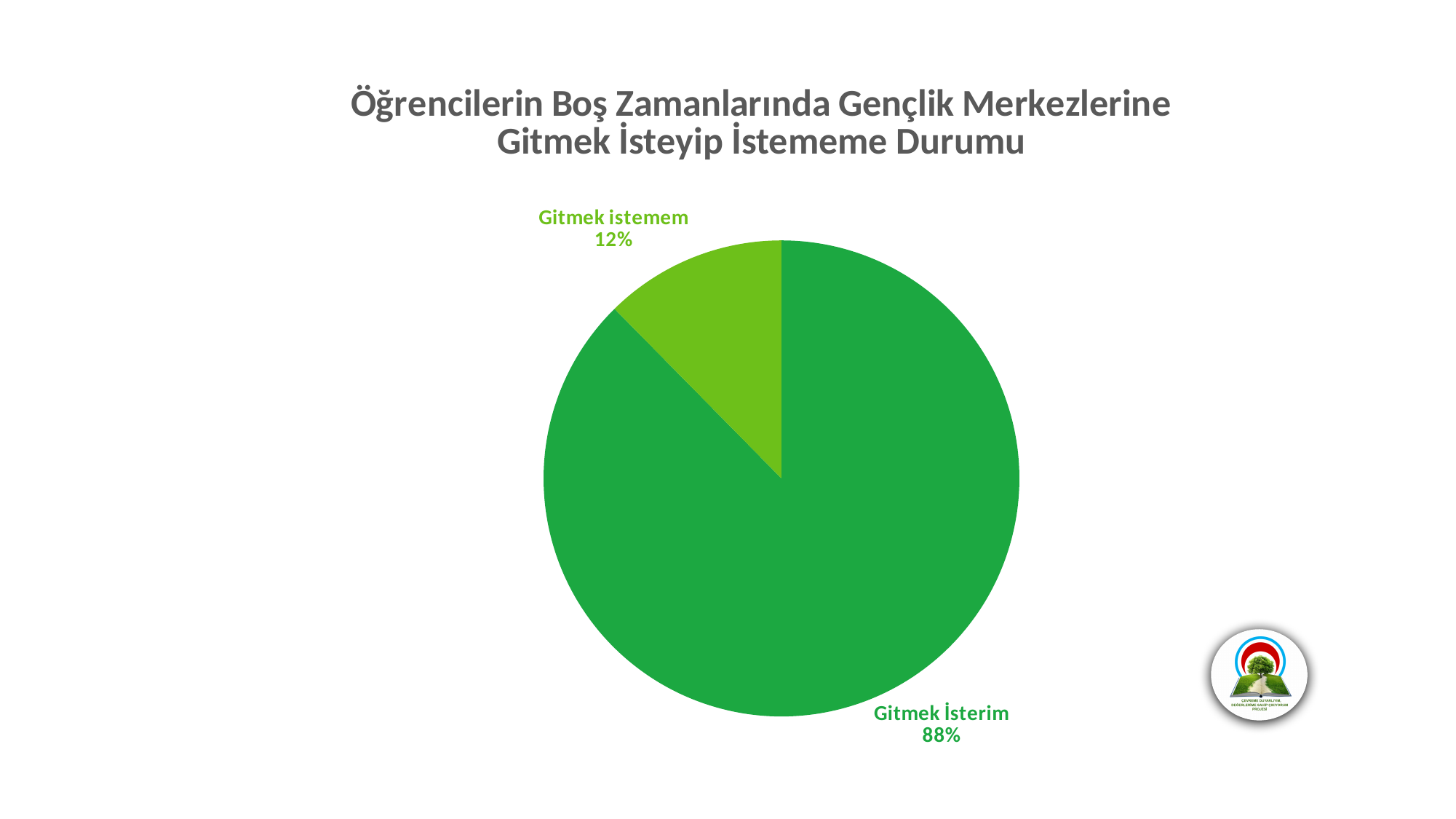
What is the difference in percentage points between "Gitmek İsterim" and "Gitmek istemem"? 76 What share of the pie does the "Gitmek istemem" slice represent? 12% What percentage of students answered "Gitmek istemem"? 12% Which category has the largest share of the pie? Gitmek İsterim What percentage of students answered "Gitmek İsterim"? 88% What kind of chart is shown on the slide? Pie chart What is the title of the chart? Öğrencilerin Boş Zamanlarında Gençlik Merkezlerine Gitmek İsteyip İstememe Durumu How many categories are shown in the pie chart? 2 Which slice is drawn in the lighter green colour? Gitmek istemem Which is larger: the share for "Gitmek İsterim" or for "Gitmek istemem"? Gitmek İsterim Which category has the smallest share of the pie? Gitmek istemem